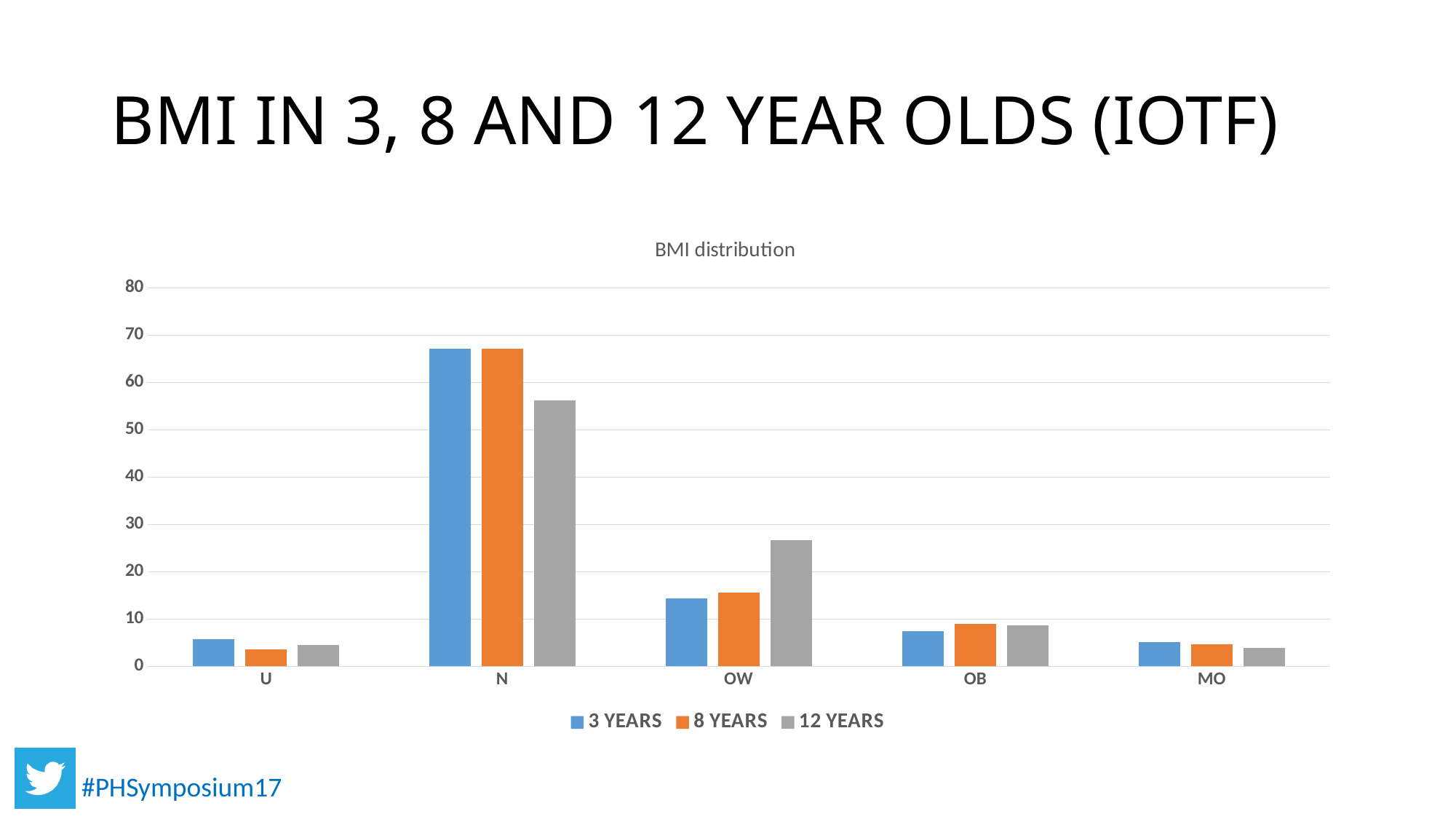
How many series does the legend list? 3 Is the 3 YEARS value for N greater or less than 60? greater For the N category, which is larger: the 3 YEARS value or the 12 YEARS value? 3 YEARS For the OW category, which is larger: the 3 YEARS value or the 12 YEARS value? 12 YEARS What kind of chart is shown on the slide? bar chart Is the 12 YEARS value for OW greater or less than 20? greater Which category has the highest value for the 3 YEARS series? N Which category has the highest value for the 12 YEARS series? N Is the 12 YEARS value for N greater or less than 50? greater How many categories are shown on the x axis? 5 What is the title of the chart? BMI distribution